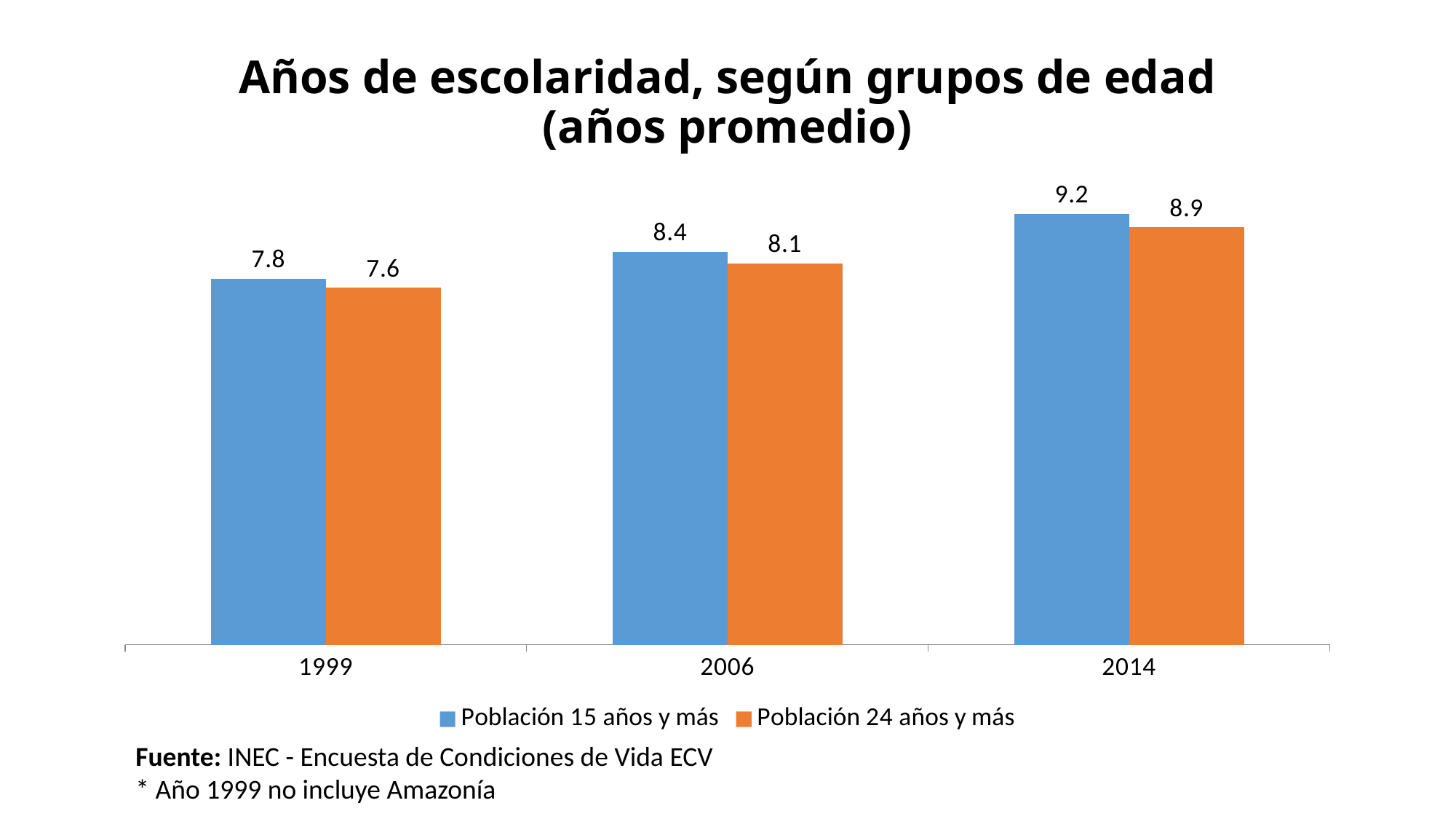
What is the value for Población 24 años y más in 1999? 7.6 Which year has the lowest value for Población 24 años y más? 1999 Which is larger in 2006: Población 15 años y más or Población 24 años y más? Población 15 años y más What is the value for Población 15 años y más in 2006? 8.4 What kind of chart is shown on the slide? Bar chart How many years are shown on the x axis? 3 Do the values for Población 24 años y más rise or fall from 1999 to 2014? Rise What is the difference between Población 15 años y más and Población 24 años y más in 2014? 0.3 What is the value for Población 24 años y más in 2014? 8.9 Which year has the highest value for Población 15 años y más? 2014 What is the difference between the 2014 and 1999 values for Población 15 años y más? 1.4 How many series does the legend list? 2